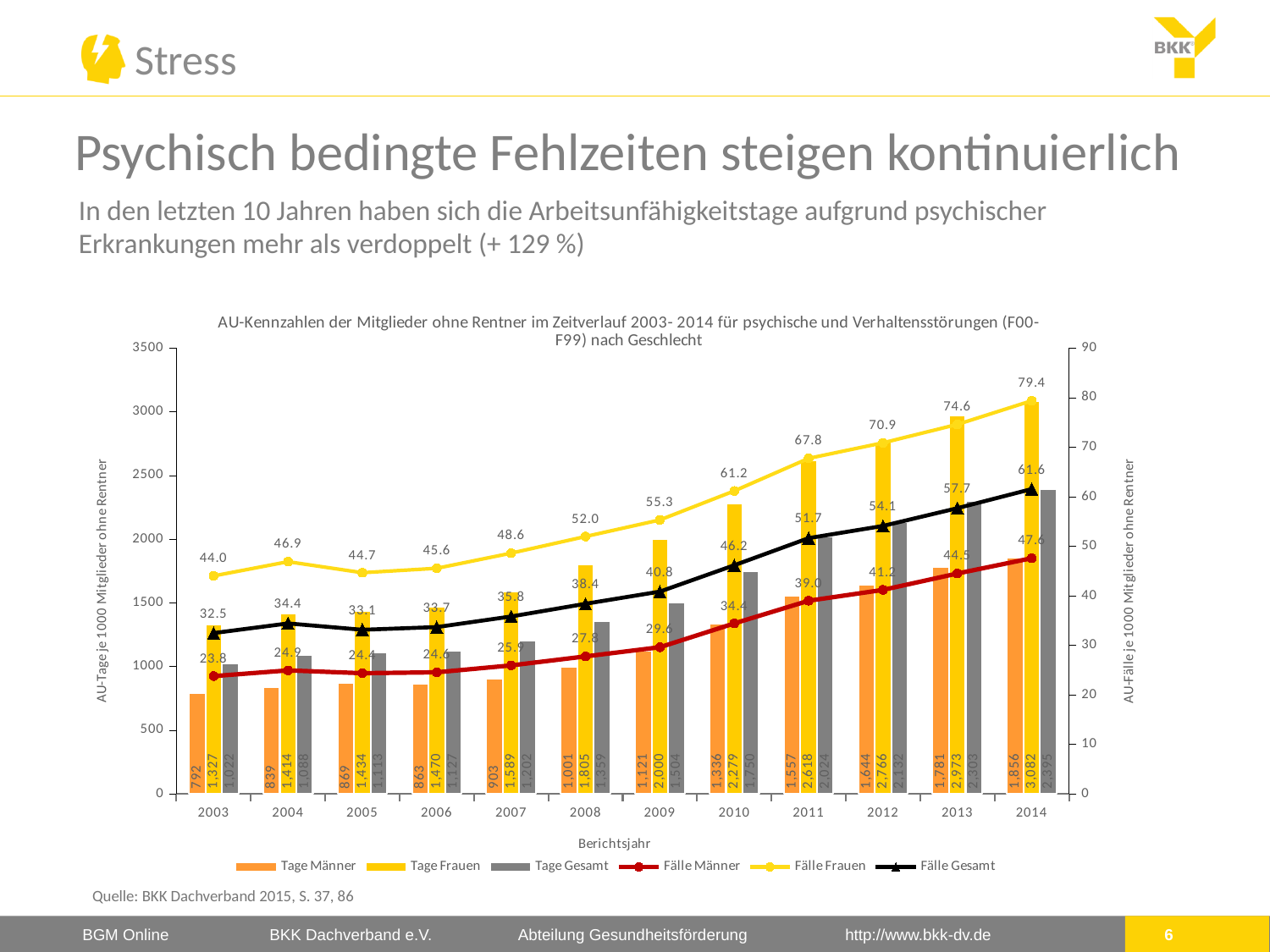
What is the value of Fälle Frauen in 2011? 67.8 How many years (Berichtsjahr) are shown on the x axis? 12 What is the value of Tage Frauen in 2014? 3,082 How many series does the legend list? 6 What kind of chart is shown on the slide? Combined bar and line chart What is the value of Tage Gesamt in 2010? 1,750 In which year is Fälle Gesamt highest? 2014 What is the difference between Tage Frauen and Tage Männer in 2014? 1,226 What is the value of Fälle Männer in 2003? 23.8 In which year is Tage Männer lowest? 2003 Which is larger in 2008: Tage Gesamt or Tage Männer? Tage Gesamt Does Fälle Frauen rise or fall from 2006 to 2014? Rise